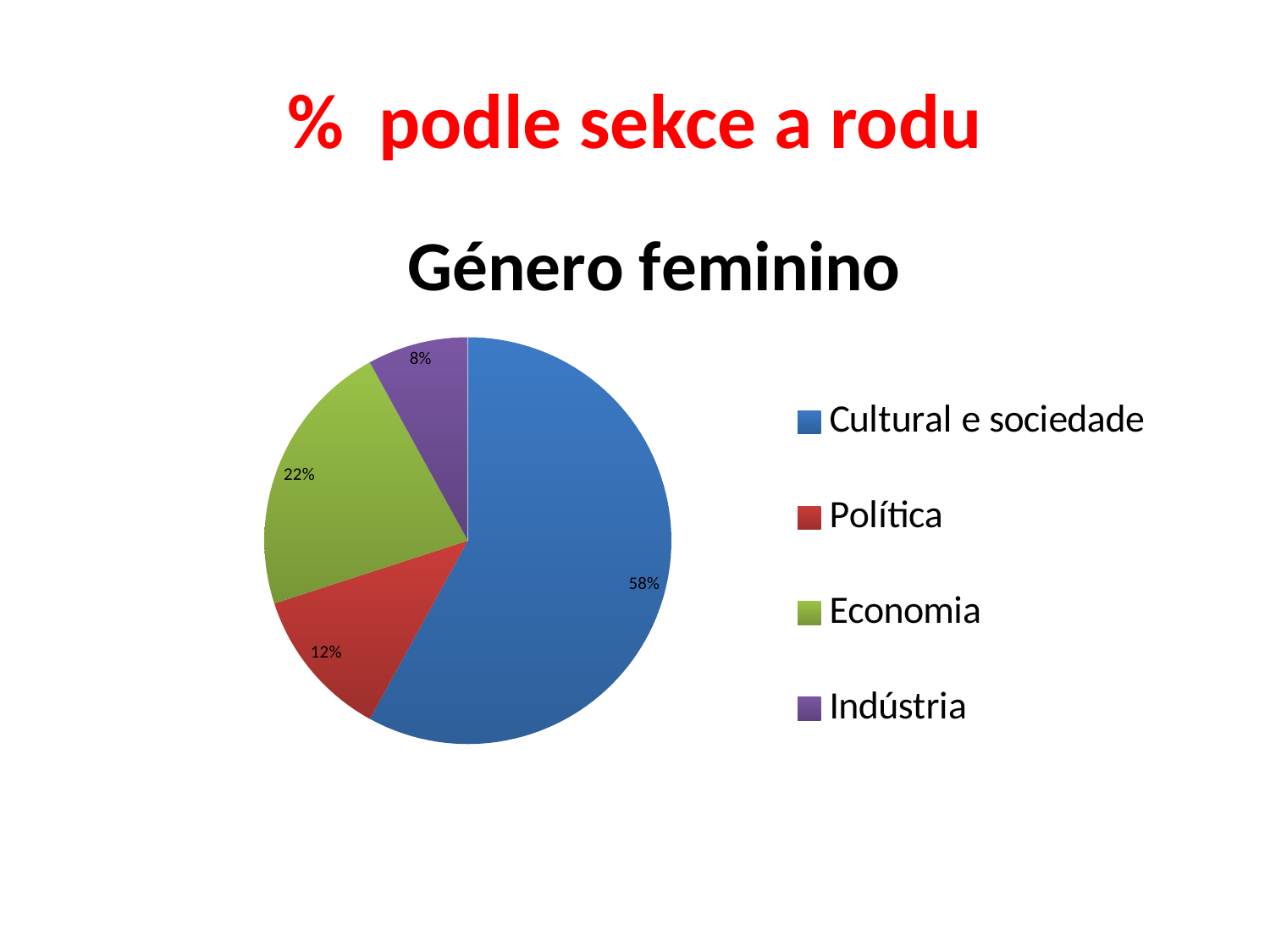
Which category has the largest slice of the pie? Cultural e sociedade What is the difference in percentage points between Economia and Política? 10 What share of the pie does Economia have? 22% Which is larger, the slice for Política or the slice for Economia? Economia How many categories does the pie chart show? 4 What is the title of the chart? Género feminino Which category has the smallest slice of the pie? Indústria What kind of chart is shown on the slide? pie chart What share of the pie does Indústria have? 8% Which colour represents Economia in the legend? green What share of the pie does Cultural e sociedade have? 58%